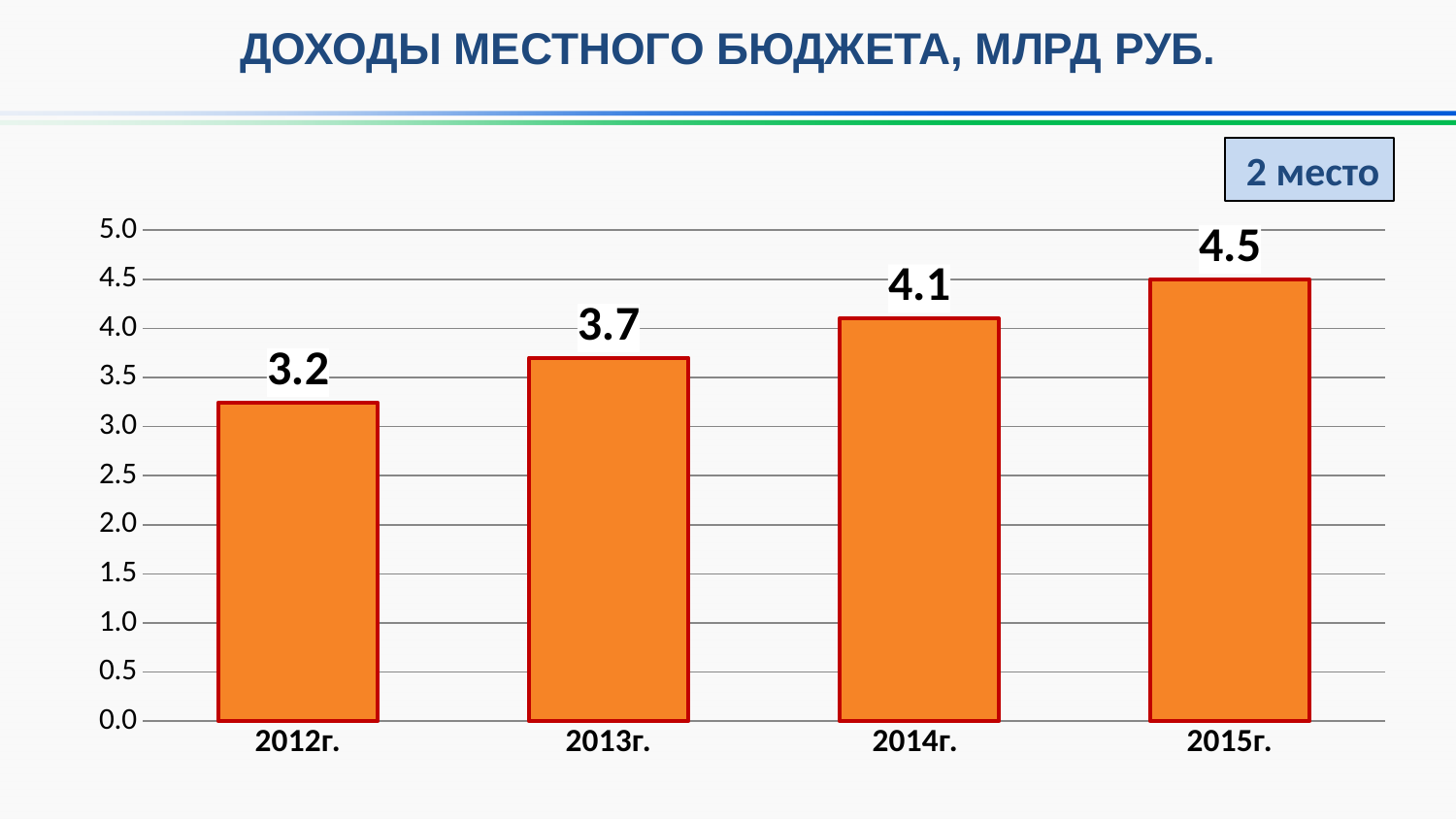
What is the value for 2015г.? 4.5 Which year has the highest value? 2015г. How many years are shown on the chart? 4 Is the value for 2014г. greater or less than 4.0? greater Do the values rise or fall from 2012г. to 2015г.? rise What is the value for 2014г.? 4.1 What is the value for 2012г.? 3.2 Which is larger, the value for 2013г. or the value for 2014г.? 2014г. What is the difference between the values for 2015г. and 2012г.? 1.3 Which year has the lowest value? 2012г. What is the value for 2013г.? 3.7 What kind of chart is shown on the slide? bar chart